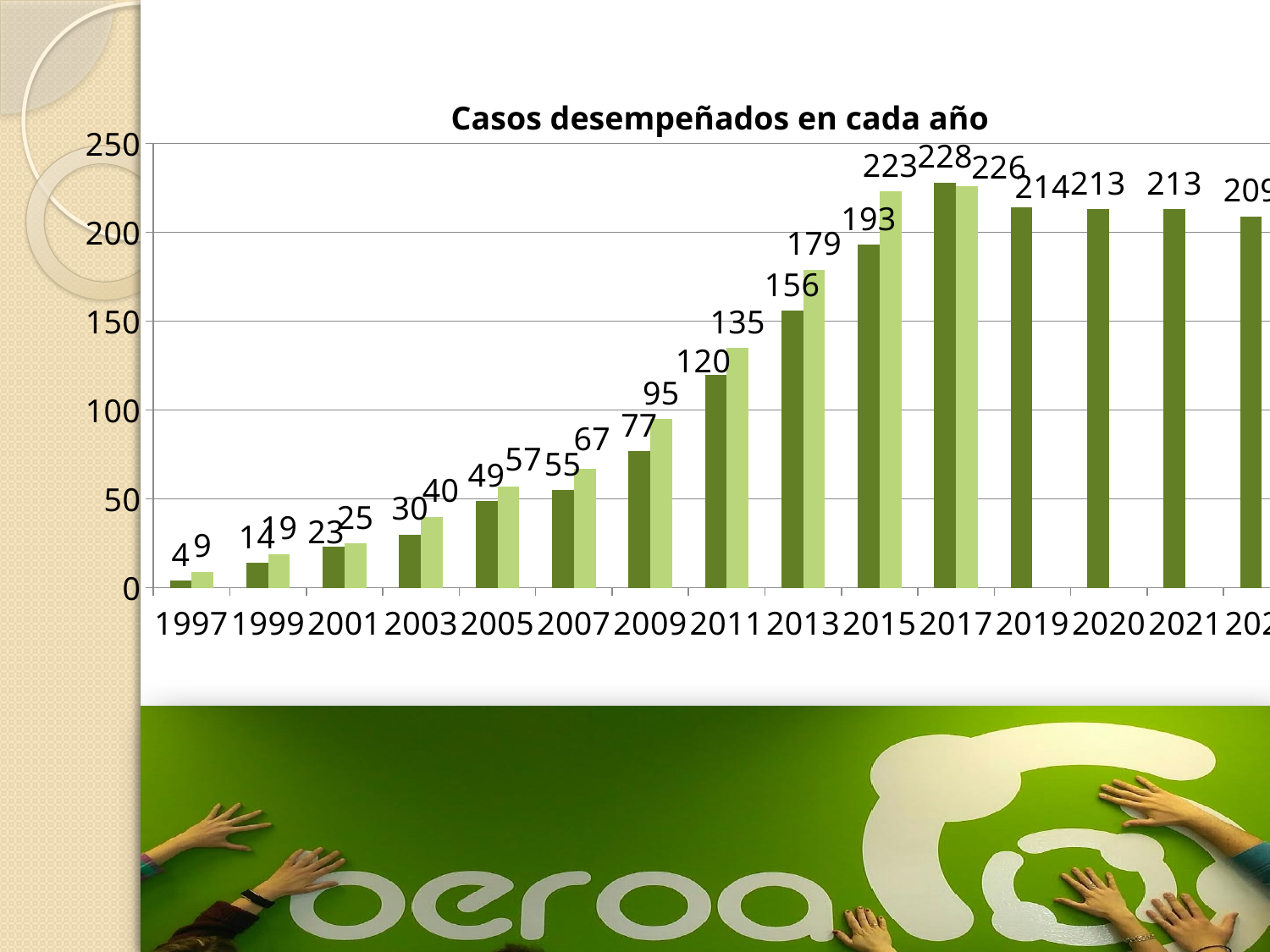
Is the value for 2019 greater or less than 200? greater What is the difference between the light green and dark green bars for 2009? 18 Which is larger: the dark green bar for 2013 or the dark green bar for 2015? the dark green bar for 2015 What is the difference between the light green and dark green bars for 2015? 30 What is the value of the dark green bar for 2011? 120 What is the value shown for 2021? 213 Which bar has the lowest value in the chart? the dark green bar for 1997 (4) What is the title of the chart? Casos desempeñados en cada año What kind of chart is shown on the slide? bar chart Which bar has the highest value in the chart? the dark green bar for 2017 (228) What is the value of the light green bar for 2003? 40 What is the value of the light green bar for 2013? 179